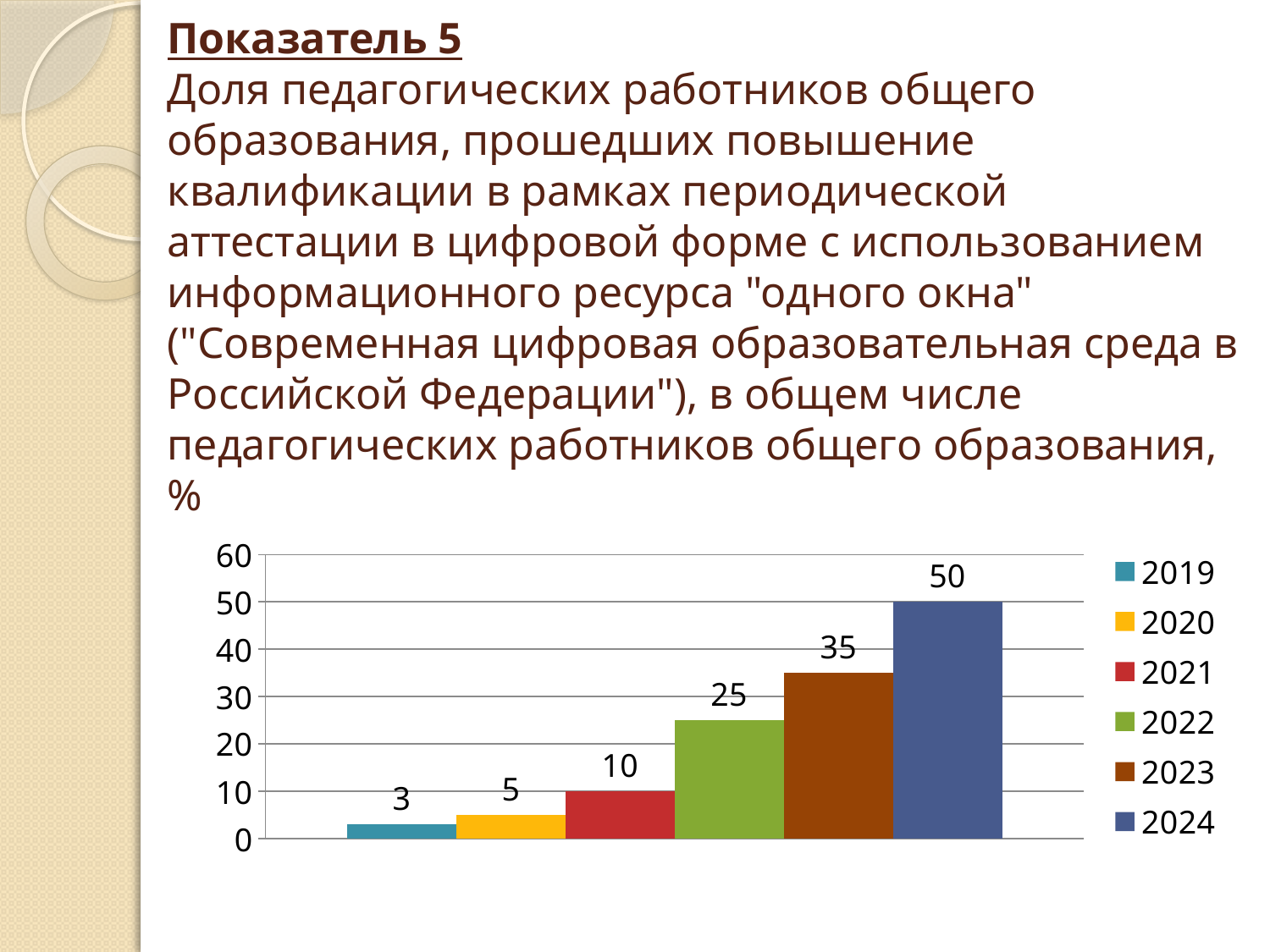
What is the value for 2022? 25 How many series does the legend list? 6 What is the difference between the values for 2024 and 2023? 15 Do the values rise or fall from 2019 to 2024? rise Which is larger, the value for 2021 or the value for 2023? 2023 Which year has the highest value? 2024 What is the difference between the values for 2022 and 2020? 20 What is the value for 2024? 50 What kind of chart is shown on the slide? bar chart What is the value for 2019? 3 What colour is the bar for 2021? red Which year has the lowest value? 2019